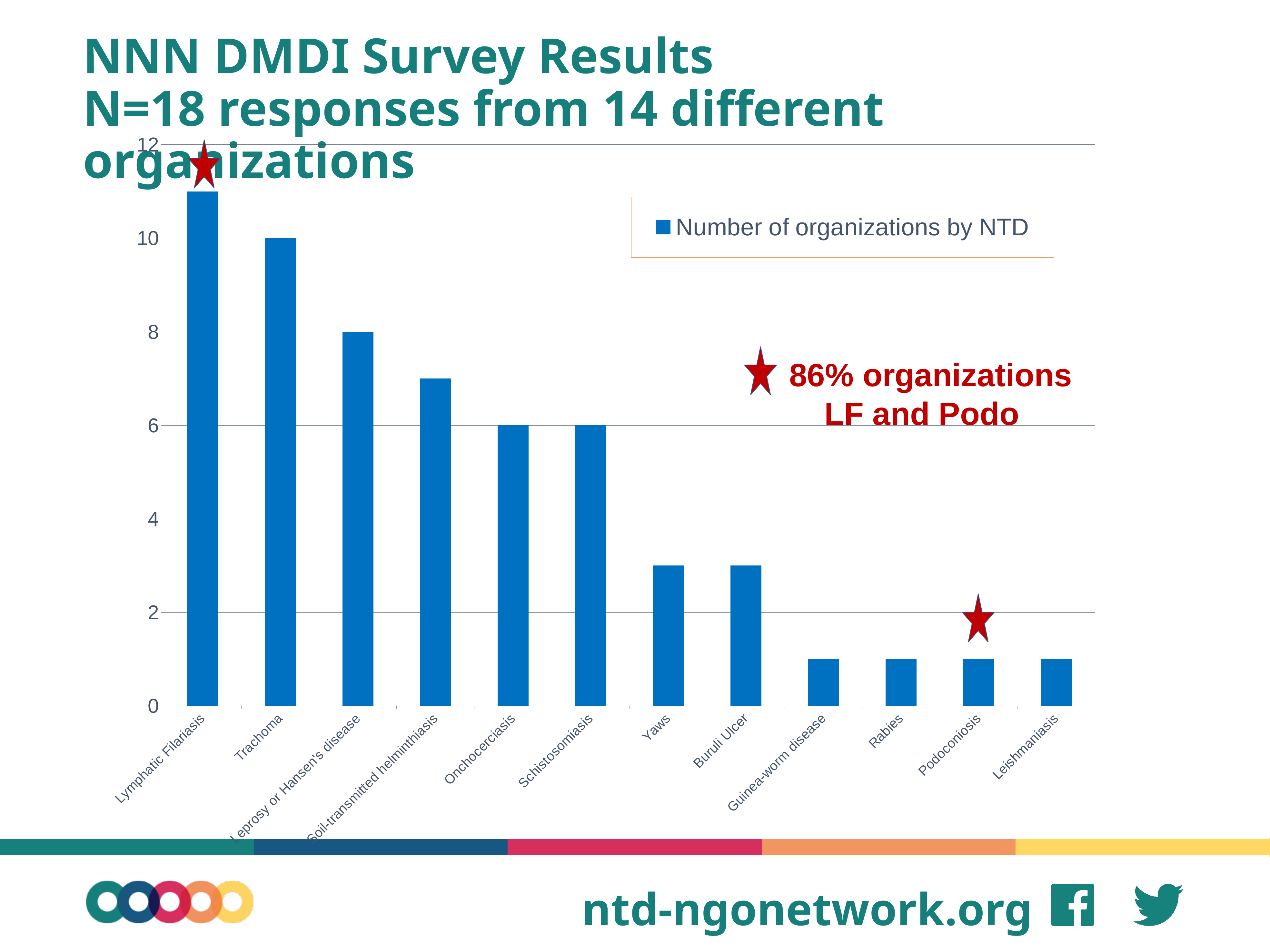
What is the difference between the values for Trachoma and Leprosy or Hansen's disease? 2 Is the value for Yaws greater or less than 4? less Which has a larger value, Trachoma or Soil-transmitted helminthiasis? Trachoma What is the number of organizations for Trachoma? 10 Is the value for Guinea-worm disease greater or less than 2? less What is the number of organizations for Leprosy or Hansen's disease? 8 Do the values rise or fall from left to right along the x axis? fall What is the number of organizations for Onchocerciasis? 6 How many NTD categories are shown on the x axis? 12 What kind of chart is shown on the slide? bar chart Is the value for Lymphatic Filariasis greater or less than 10? greater Which NTD has the highest number of organizations? Lymphatic Filariasis